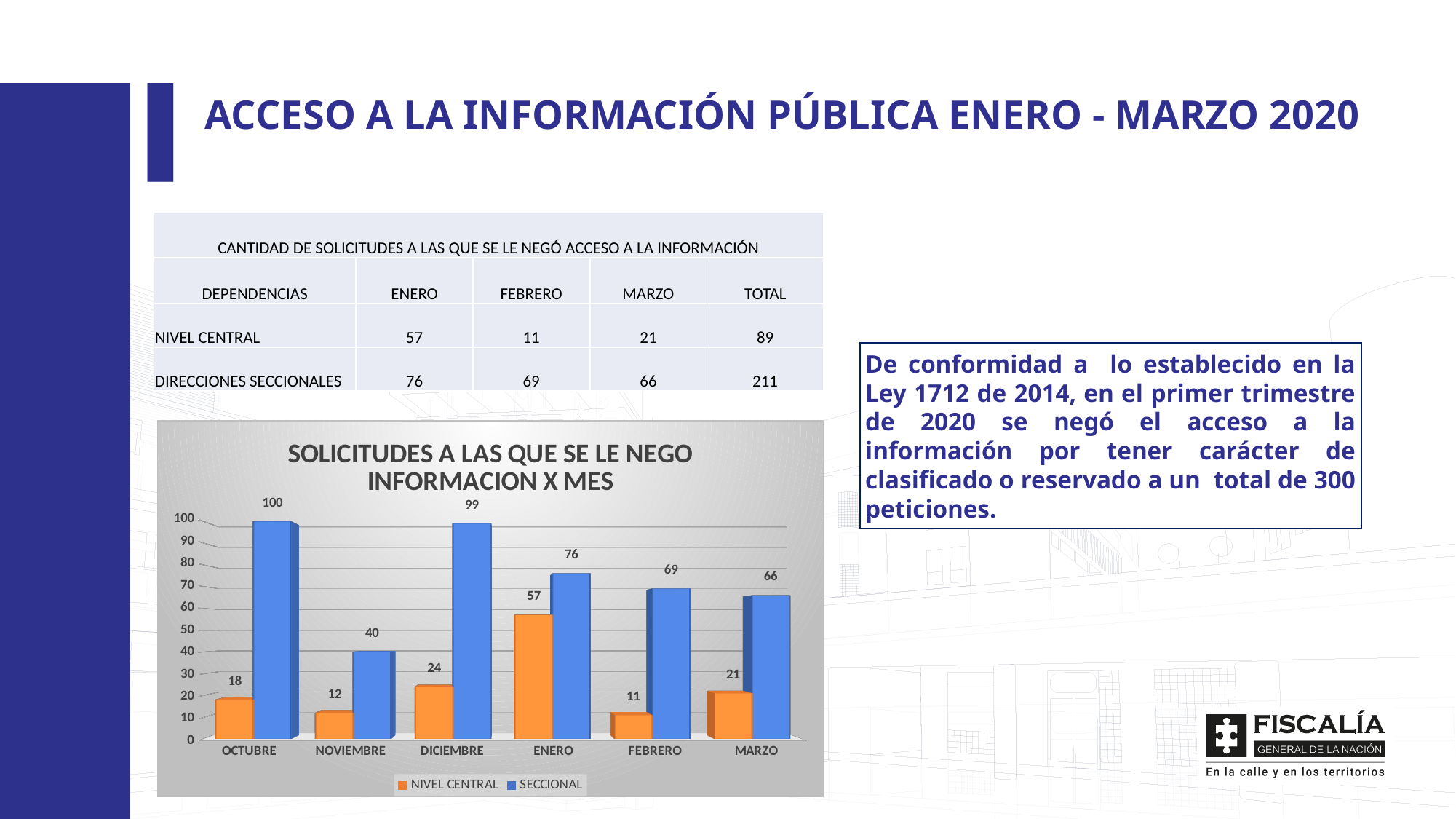
How many months are shown on the x axis of the chart? 6 Which is larger: the NIVEL CENTRAL value in MARZO or the NIVEL CENTRAL value in FEBRERO? MARZO What is the value for SECCIONAL in FEBRERO? 69 What is the title of the chart? SOLICITUDES A LAS QUE SE LE NEGO INFORMACION X MES Which month has the highest value for NIVEL CENTRAL? ENERO What is the value for SECCIONAL in OCTUBRE? 100 What is the difference between the SECCIONAL and NIVEL CENTRAL values in DICIEMBRE? 75 How many series does the chart legend list? 2 What kind of chart is shown on the slide? Bar chart Is the value for SECCIONAL in MARZO greater or less than 50? greater What is the value for NIVEL CENTRAL in ENERO? 57 Which month has the lowest value for SECCIONAL? NOVIEMBRE